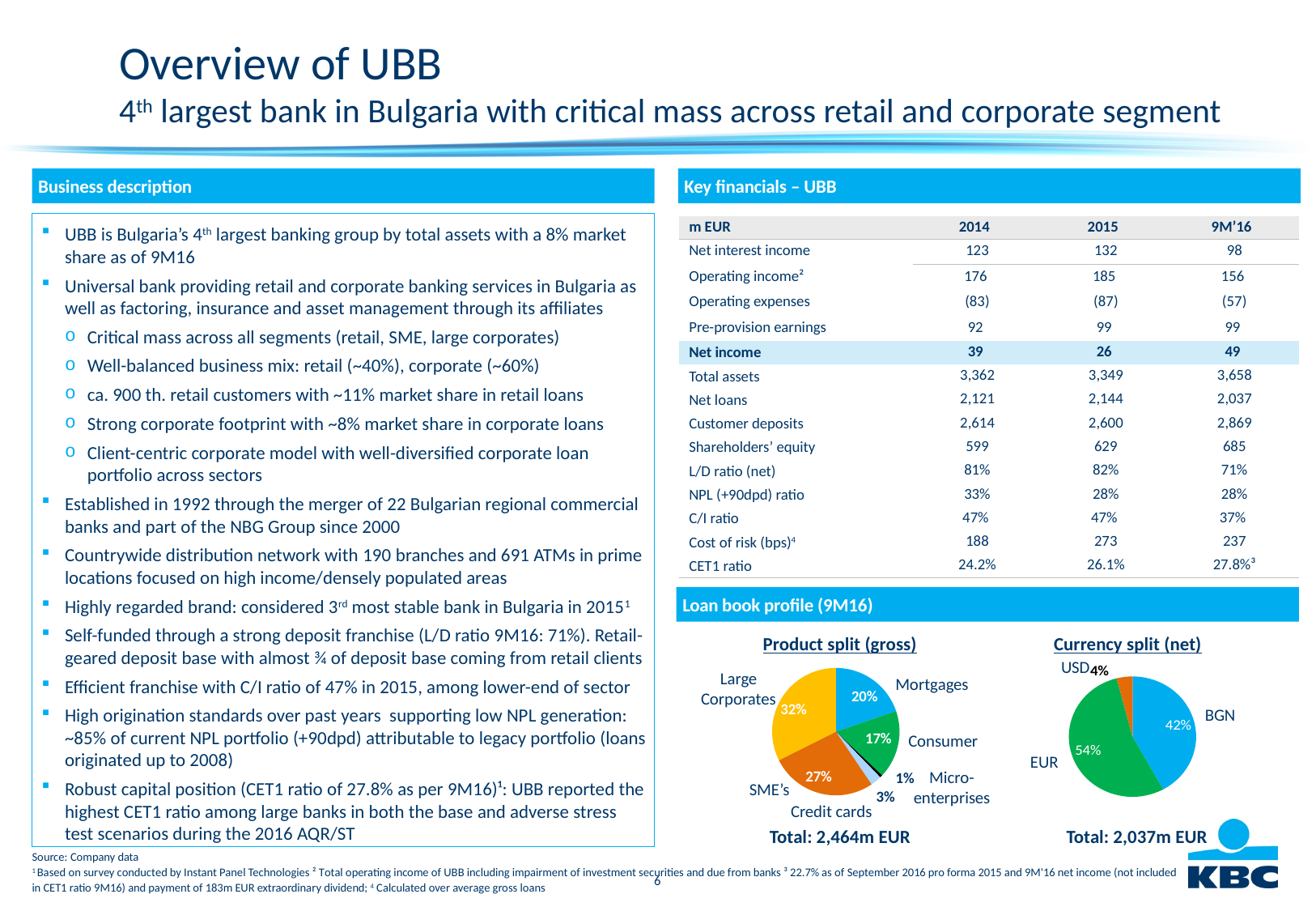
In the Currency split (net) pie chart, which is larger, the share for BGN or the share for EUR? EUR In the Product split (gross) pie chart, what share do SME's represent? 27% In the Product split (gross) pie chart, which category has the smallest share? Micro-enterprises In the Product split (gross) pie chart, what share do Mortgages represent? 20% In the Currency split (net) pie chart, what share does USD represent? 4% What type of chart is used for the Currency split (net)? Pie chart In the Currency split (net) pie chart, which currency has the largest share? EUR In the Currency split (net) pie chart, what share does EUR represent? 54% In the Product split (gross) pie chart, what share do Large Corporates represent? 32% In the Product split (gross) pie chart, how many categories are shown? 6 In the Product split (gross) pie chart, which category has the largest share? Large Corporates In the Product split (gross) pie chart, what is the difference in share between Large Corporates and SME's? 5%